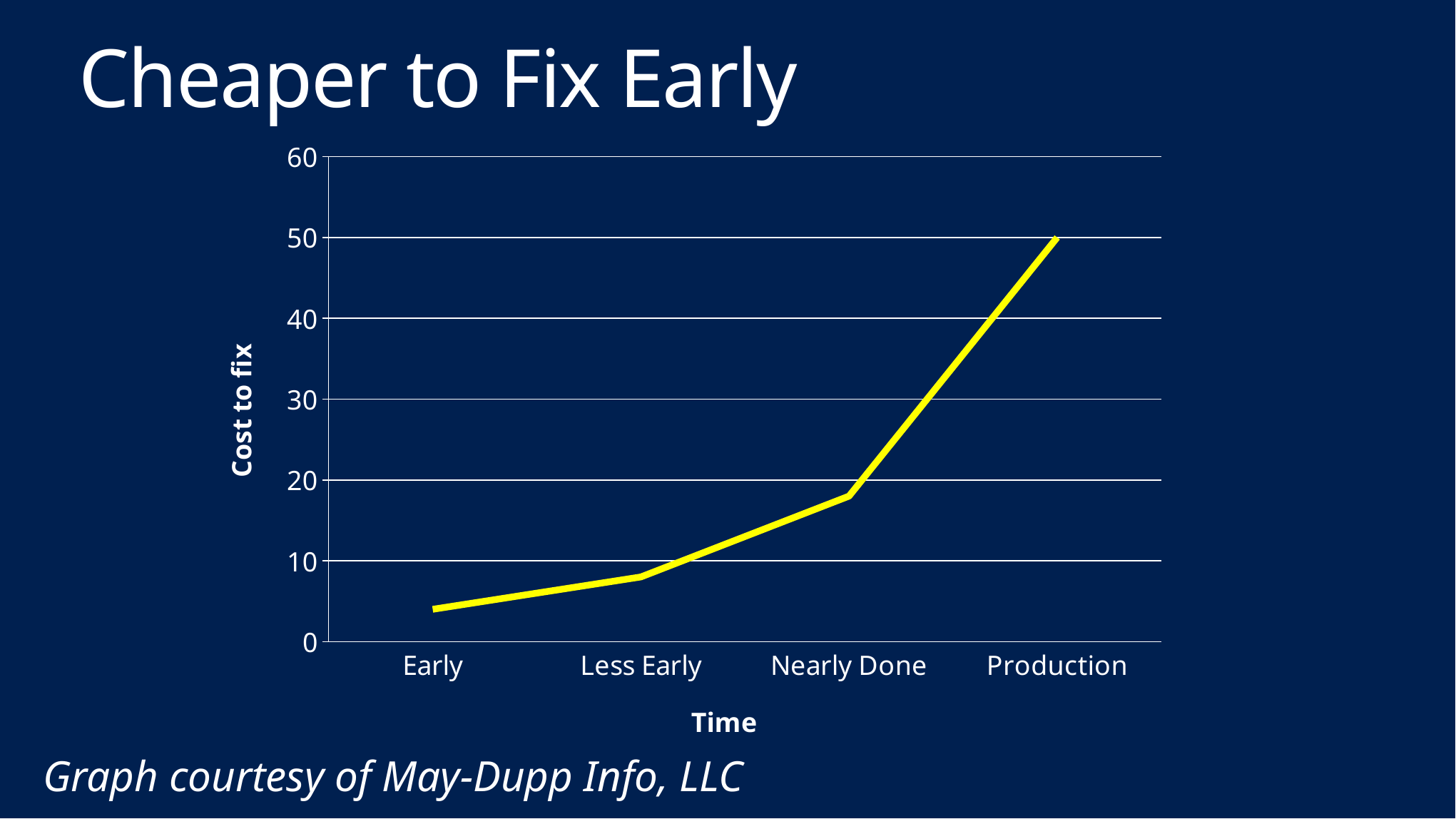
How many categories are plotted along the x axis? 4 Do the values rise or fall from Early to Production? rise What is the label on the vertical axis? Cost to fix What kind of chart is shown on the slide? line chart Is the value for Production greater or less than 40? greater Which has a higher cost to fix, Less Early or Nearly Done? Nearly Done Which category has the lowest cost to fix? Early Is the value for Early greater or less than 10? less Is the value for Nearly Done greater or less than 20? less Which category has the highest cost to fix? Production What is the cost to fix at Production? 50 What is the label on the horizontal axis? Time